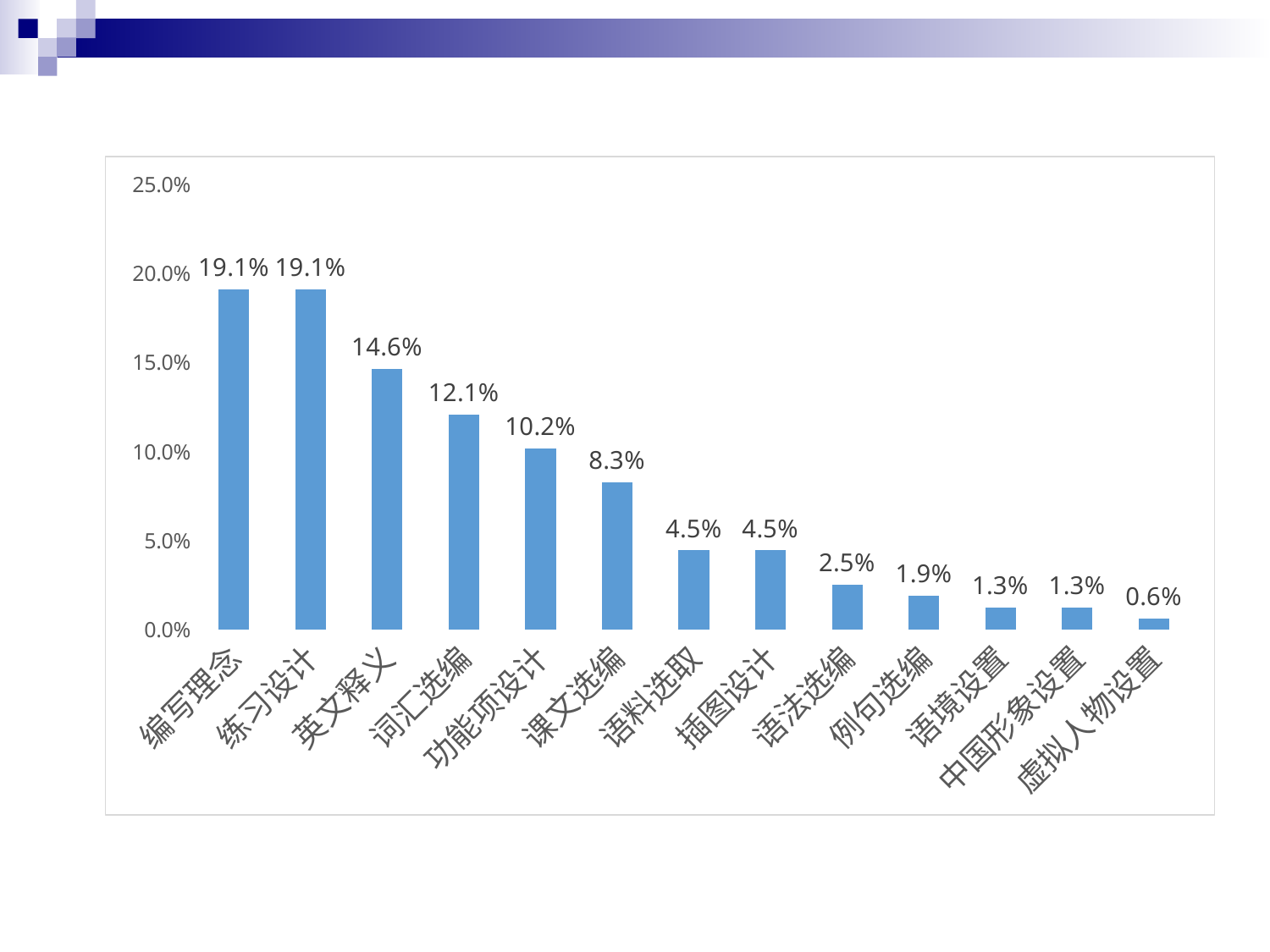
What is the value for 虚拟人物设置? 0.6% How many categories are shown in the chart? 13 What is the value for 英文释义? 14.6% Do the values rise or fall from left to right along the x axis? fall What kind of chart is shown on the slide? bar chart What is the difference between the values for 编写理念 and 课文选编? 10.8% What is the value for 语法选编? 2.5% Which category has the lowest value? 虚拟人物设置 Which is larger, the value for 英文释义 or the value for 词汇选编? 英文释义 What is the difference between the values for 词汇选编 and 例句选编? 10.2% Is the value for 课文选编 greater or less than 10.0%? less What is the value for 功能项设计? 10.2%